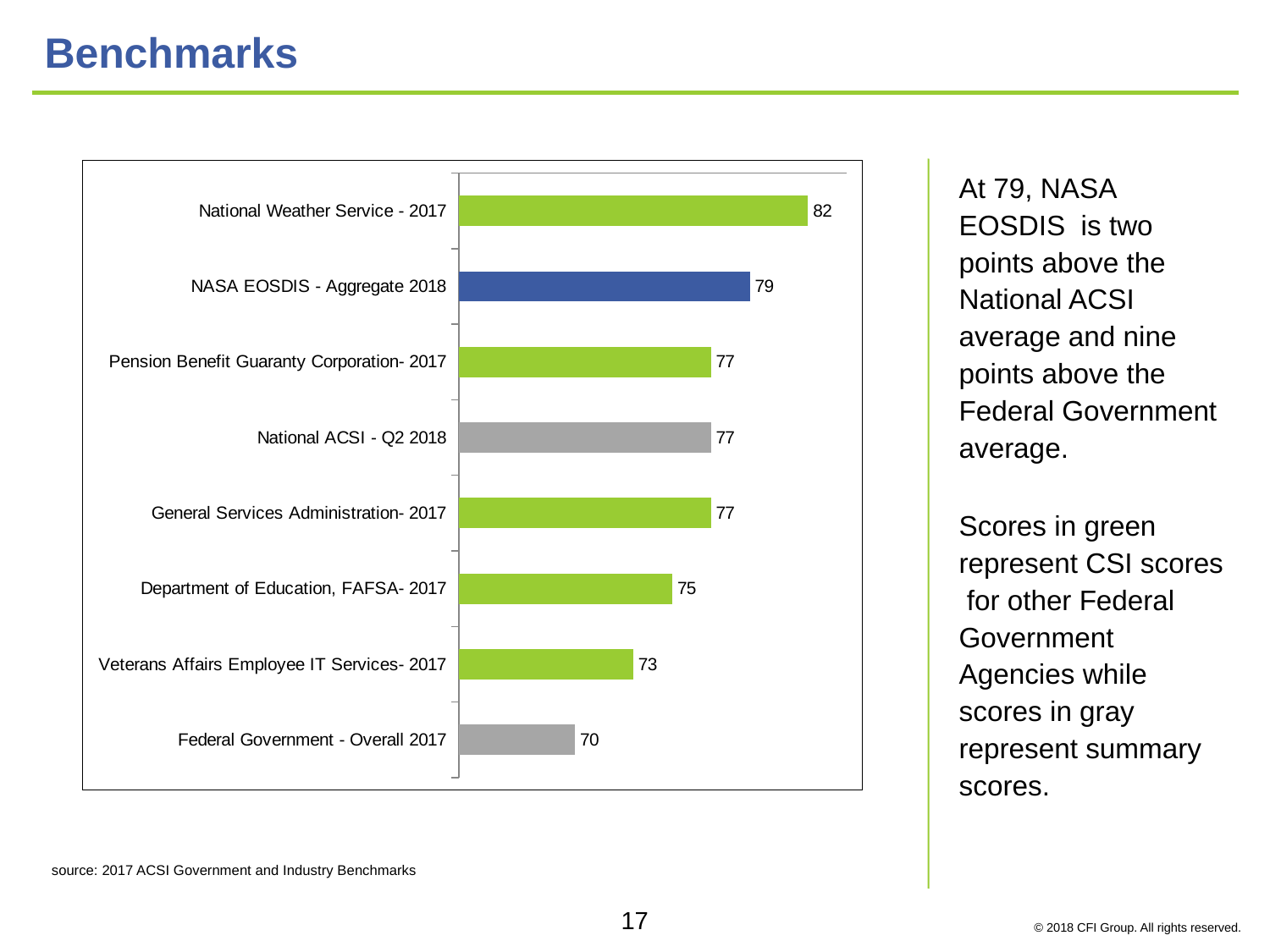
What colour is the bar for NASA EOSDIS - Aggregate 2018? Blue What is the difference between the values for NASA EOSDIS - Aggregate 2018 and Federal Government - Overall 2017? 9 What kind of chart is shown on the slide? Bar chart What is the difference between the values for National Weather Service - 2017 and Department of Education, FAFSA- 2017? 7 How many categories are shown in the chart? 8 Which is larger, the value for NASA EOSDIS - Aggregate 2018 or the value for National ACSI - Q2 2018? NASA EOSDIS - Aggregate 2018 Which category has the highest value? National Weather Service - 2017 What is the value for Veterans Affairs Employee IT Services- 2017? 73 What is the value for Federal Government - Overall 2017? 70 Which category has the lowest value? Federal Government - Overall 2017 What is the value for National Weather Service - 2017? 82 What is the value for NASA EOSDIS - Aggregate 2018? 79